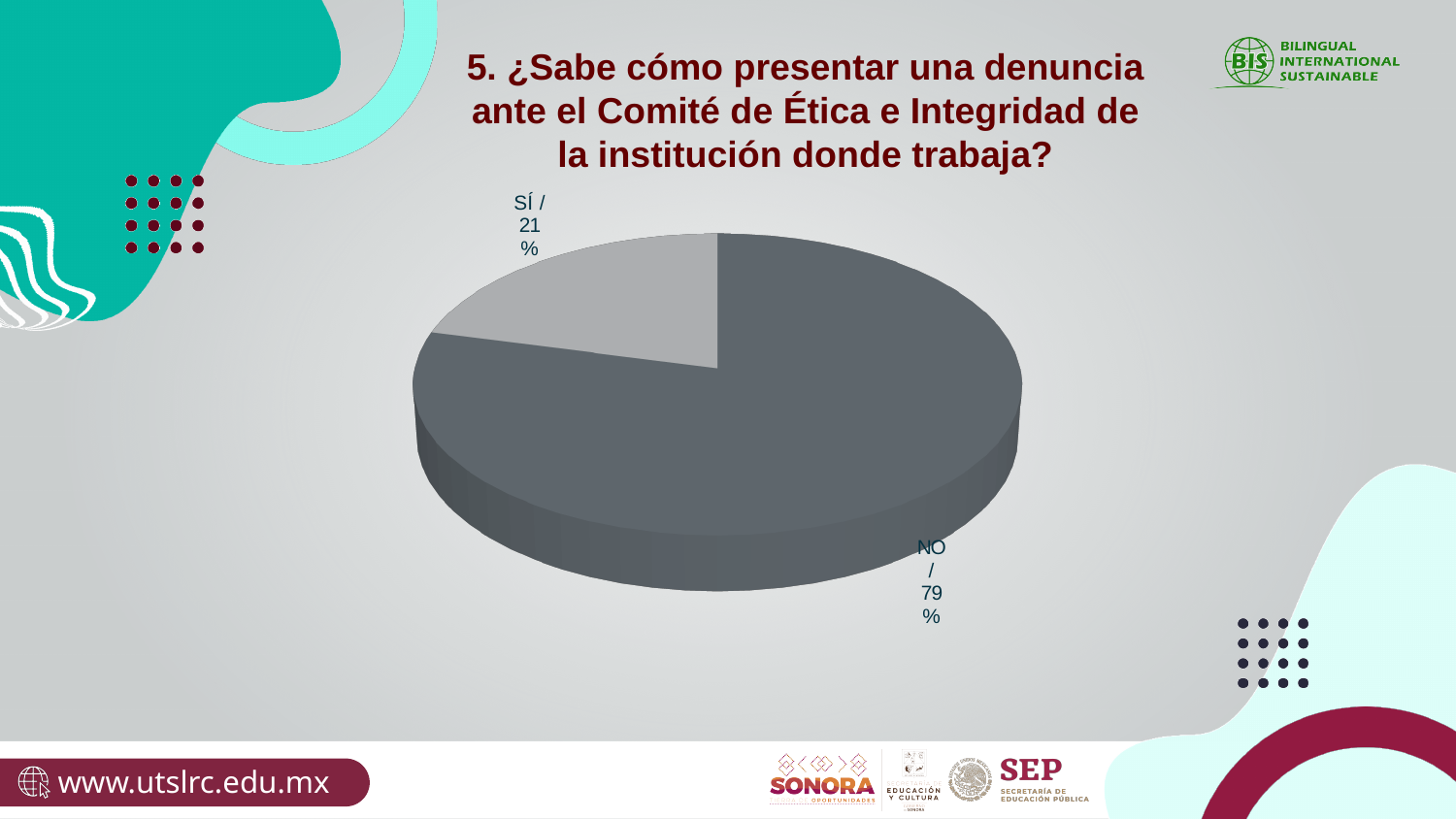
How many slices does the pie chart have? 2 Which slice is shown in the lighter grey colour? SÍ What question does the chart title ask? 5. ¿Sabe cómo presentar una denuncia ante el Comité de Ética e Integridad de la institución donde trabaja? Which response has the largest share of the pie? NO Which slice is larger, SÍ or NO? NO Is the share for NO greater or less than 50%? greater What percentage of respondents answered NO? 79% What kind of chart is shown on the slide? pie chart Which response has the smallest share of the pie? SÍ What is the difference in percentage points between the NO and SÍ slices? 58 What percentage of respondents answered SÍ? 21% Is the share for SÍ greater or less than 25%? less